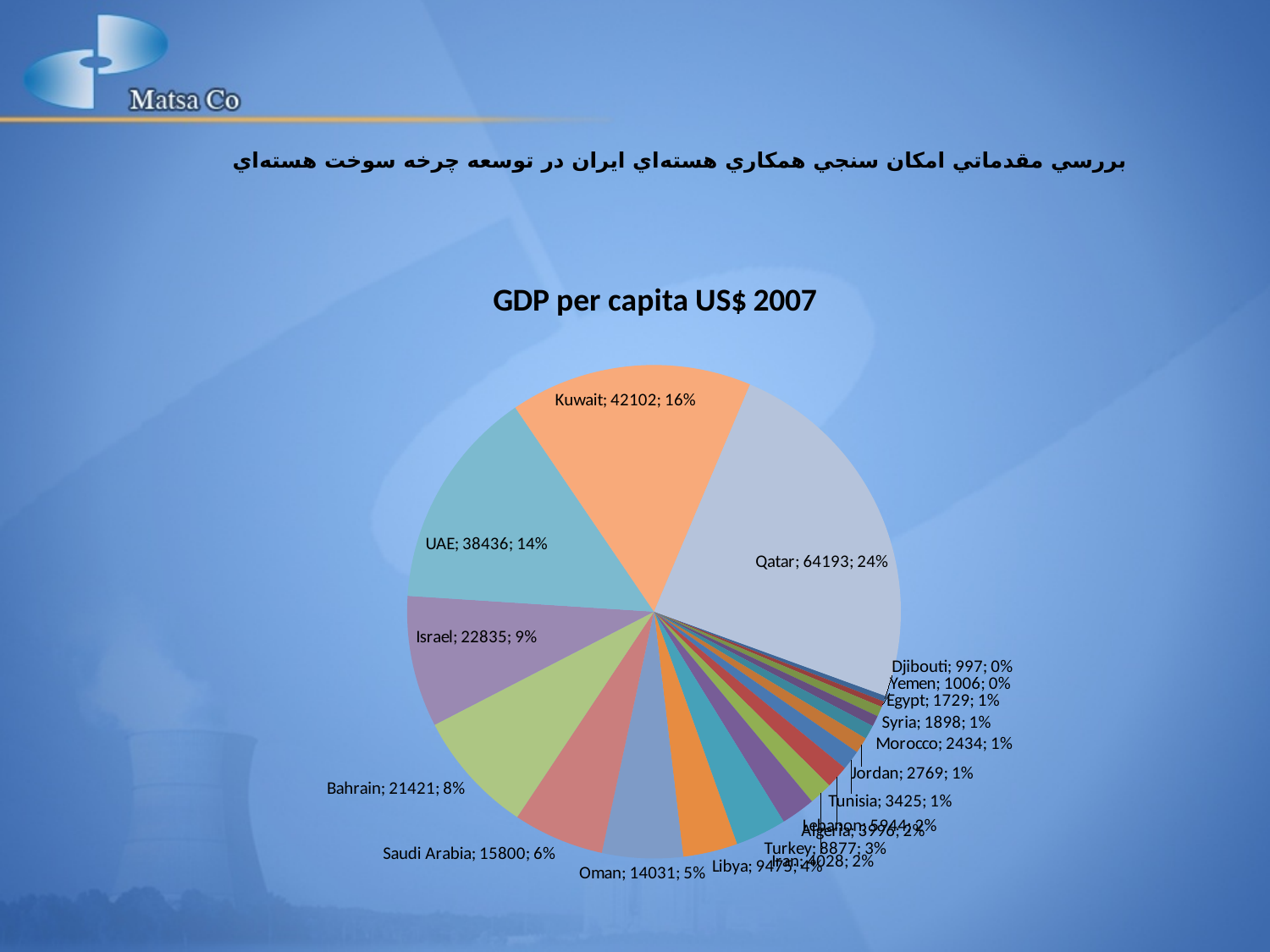
What kind of chart is shown on the slide? pie chart Which is larger, the value for UAE or the value for Israel? UAE What is the GDP per capita value shown for Saudi Arabia? 15800 What is the GDP per capita value shown for Kuwait? 42102 What is the difference between the values for Qatar and Kuwait? 22091 What share of the pie does Israel's slice represent? 9% What is the title of the chart? GDP per capita US$ 2007 What is the GDP per capita value shown for Iran? 4028 Which country has the largest slice of the pie? Qatar What is the GDP per capita value shown for UAE? 38436 What share of the pie does Qatar's slice represent? 24% What is the GDP per capita value shown for Qatar? 64193